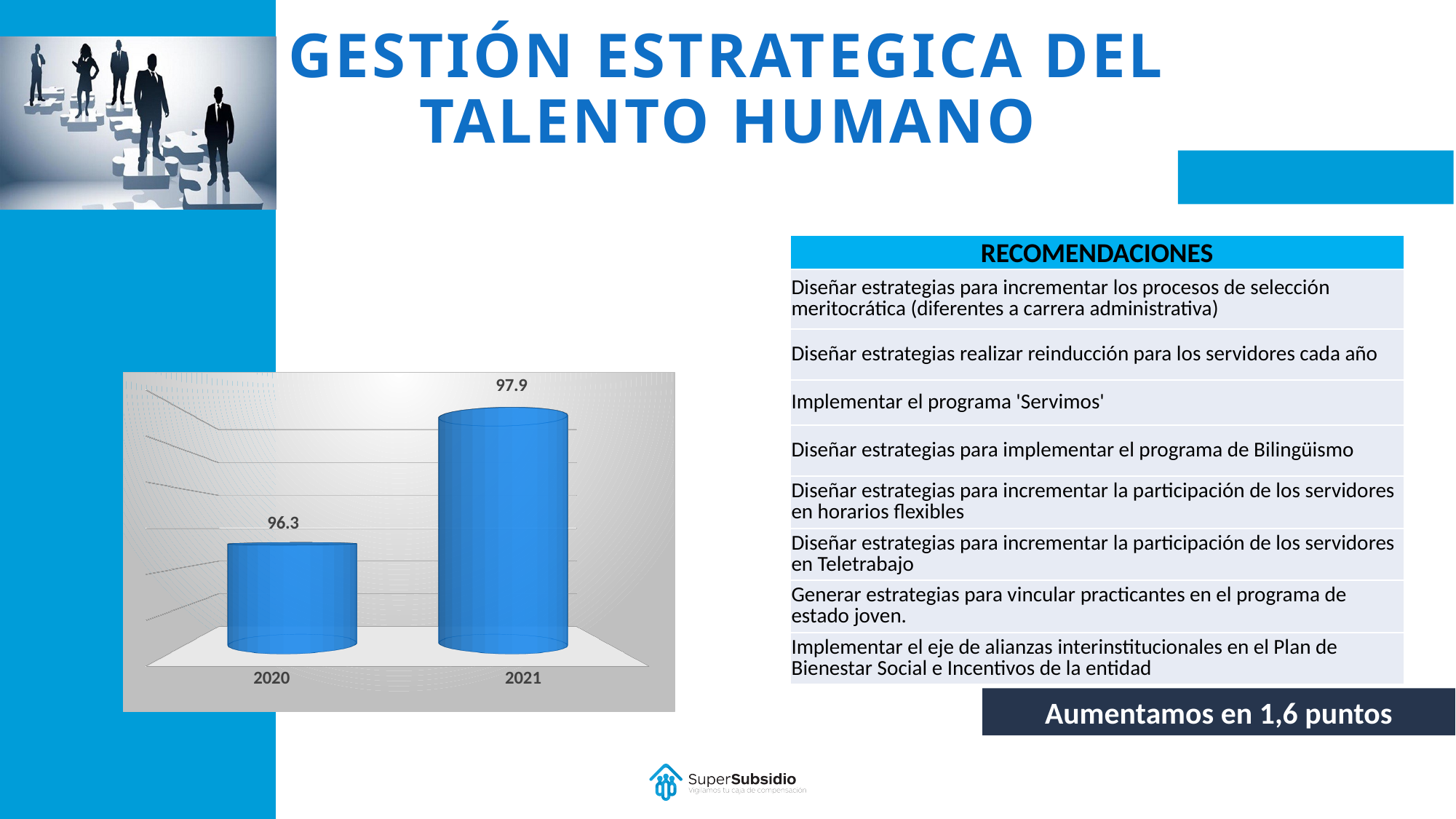
Do the values rise or fall from 2020 to 2021? rise What kind of chart is shown on the slide? bar chart What is the value for 2020? 96.3 What colour are the bars in the chart? blue Which year has the highest value? 2021 What is the difference between the 2021 and 2020 values? 1.6 How many categories are shown on the chart? 2 Which year has the lowest value? 2020 What is the value for 2021? 97.9 Which is larger, the value for 2020 or the value for 2021? 2021 Which years are shown on the x axis of the chart? 2020 and 2021